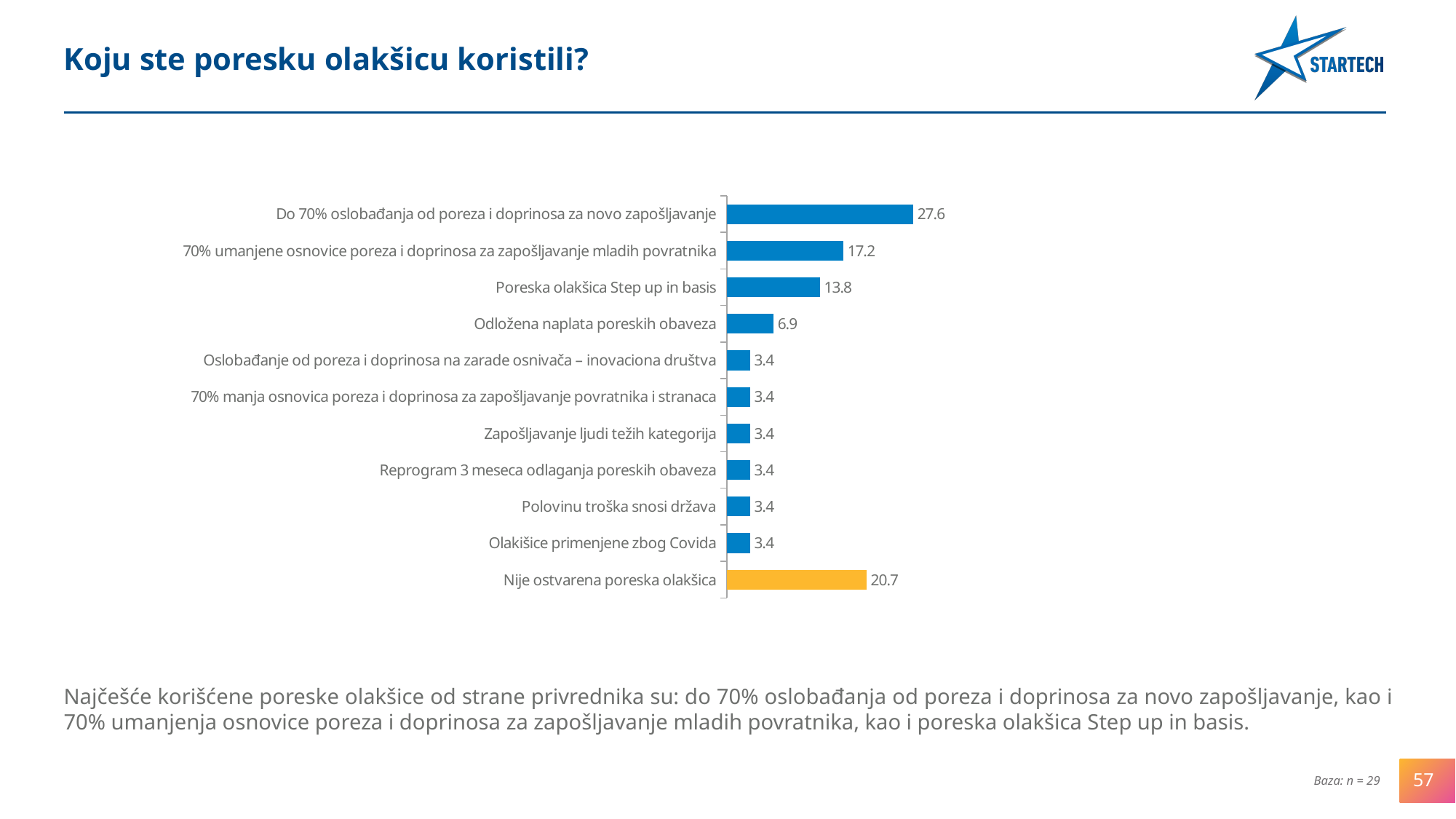
What kind of chart is shown on the slide? Bar chart What is the value for "Nije ostvarena poreska olakšica"? 20.7 Which is larger: the value for "Nije ostvarena poreska olakšica" or the value for "70% umanjene osnovice poreza i doprinosa za zapošljavanje mladih povratnika"? Nije ostvarena poreska olakšica What is the value for "Poreska olakšica Step up in basis"? 13.8 What is the value for "Do 70% oslobađanja od poreza i doprinosa za novo zapošljavanje"? 27.6 Which category's bar is coloured orange instead of blue? Nije ostvarena poreska olakšica What is the difference between the values for "Nije ostvarena poreska olakšica" and "Poreska olakšica Step up in basis"? 6.9 Which category has the highest value? Do 70% oslobađanja od poreza i doprinosa za novo zapošljavanje How many categories have a value of 3.4? 6 What is the difference between the values for "Do 70% oslobađanja od poreza i doprinosa za novo zapošljavanje" and "70% umanjene osnovice poreza i doprinosa za zapošljavanje mladih povratnika"? 10.4 How many categories are shown in the chart? 11 What is the value for "Odložena naplata poreskih obaveza"? 6.9